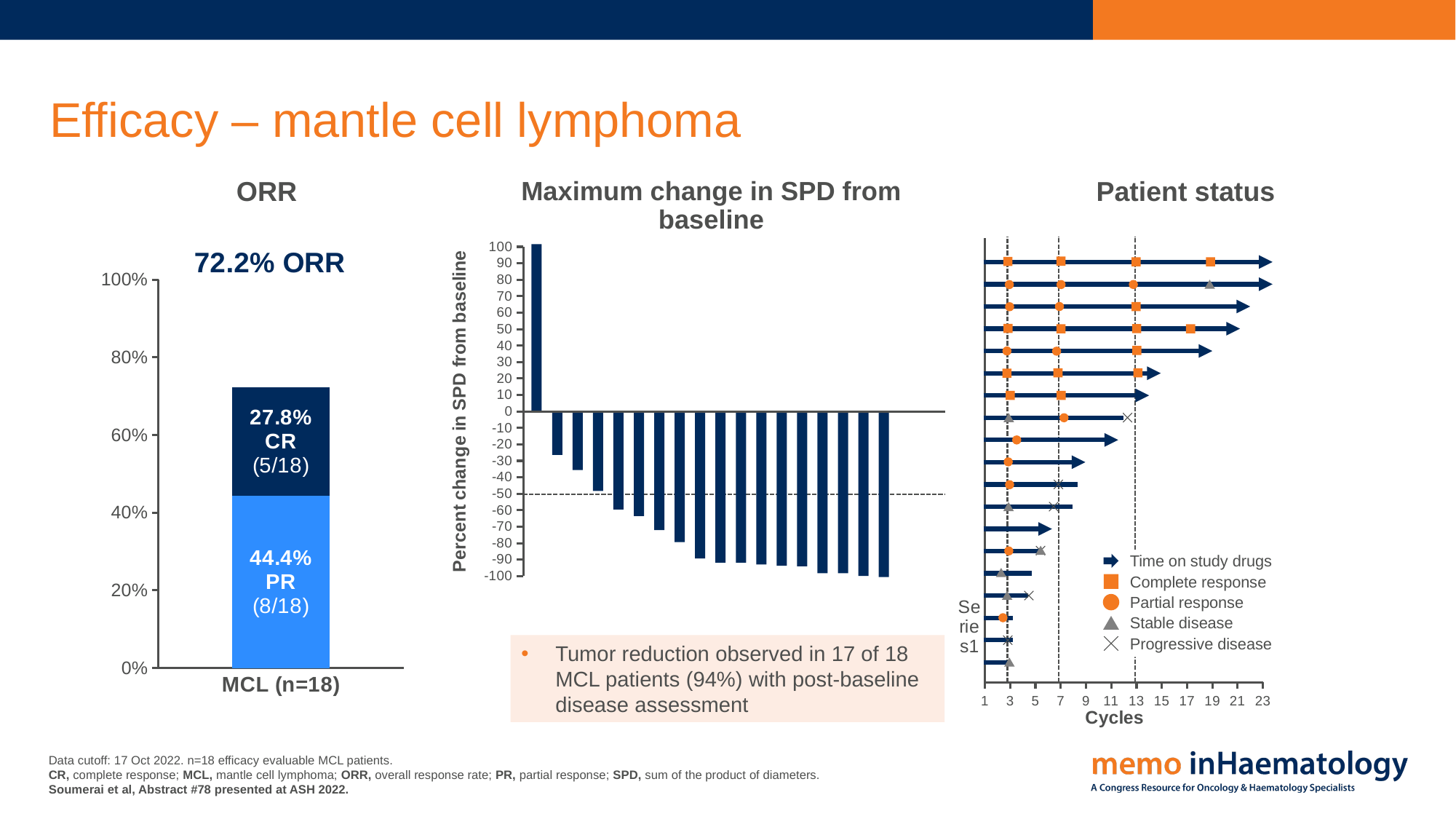
In the 'Maximum change in SPD from baseline' chart, at what value is the horizontal dashed reference line drawn? -50 In the ORR chart, what is the difference between the PR percentage and the CR percentage? 16.6% In the 'Maximum change in SPD from baseline' chart, is the value of the single positive bar greater or less than 50? greater In the ORR chart, which segment is larger, CR or PR? PR In the 'Maximum change in SPD from baseline' chart, how many bars (patients) are plotted? 18 In the 'Maximum change in SPD from baseline' chart, how many bars show a negative change from baseline? 17 In the ORR chart, what percentage of MCL patients achieved a partial response (PR)? 44.4% In the 'Patient status' chart, how many entries does the legend list? 5 In the ORR chart, what percentage of MCL patients achieved a complete response (CR)? 27.8% In the 'Maximum change in SPD from baseline' chart, what is the y-axis title? Percent change in SPD from baseline What kind of chart is the ORR chart? Stacked bar chart In the ORR chart, what is the total overall response rate shown for the MCL (n=18) bar? 72.2%